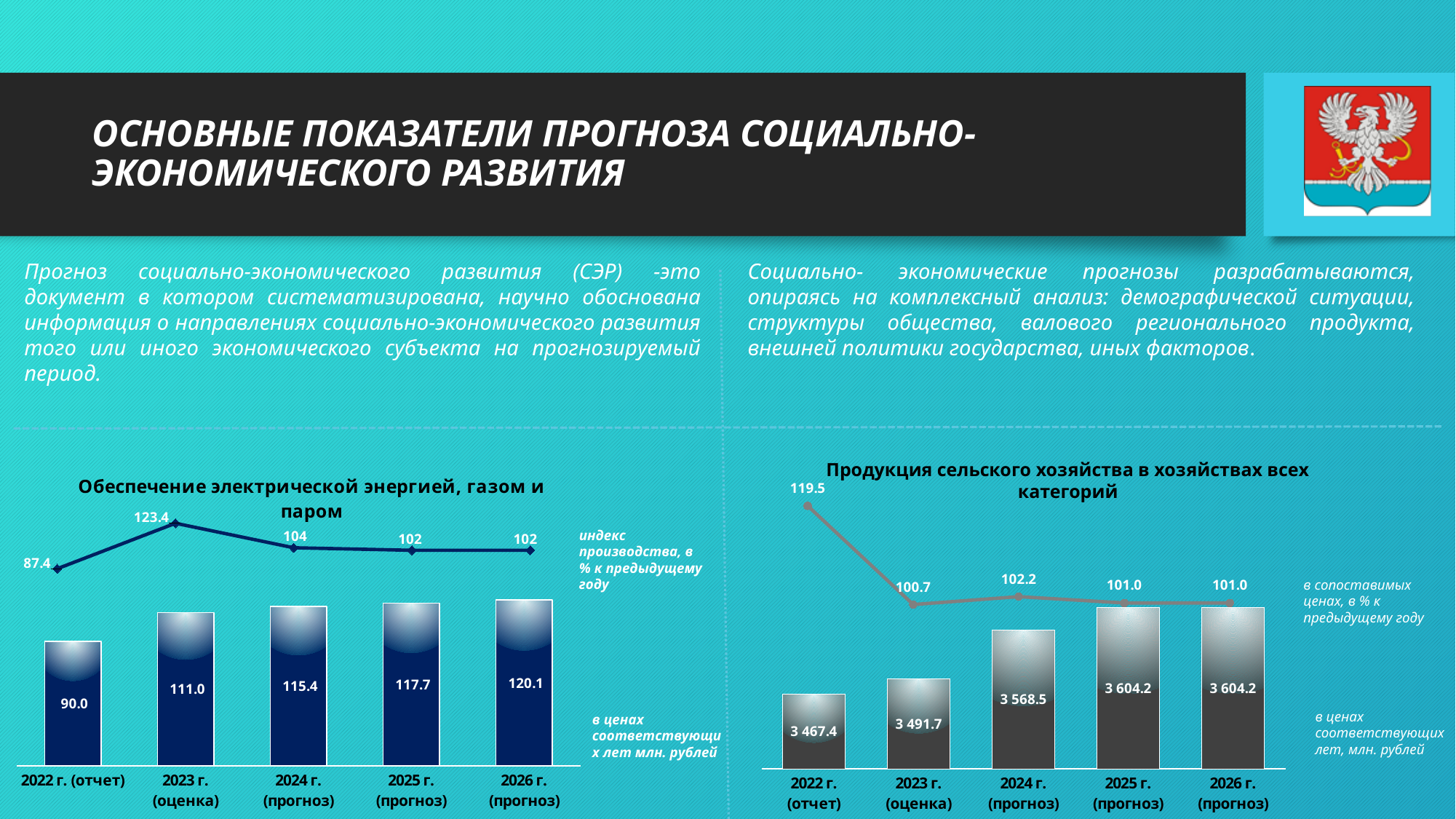
In the chart 'Продукция сельского хозяйства в хозяйствах всех категорий', which year has the lowest bar value? 2022 г. (отчет) In the chart 'Обеспечение электрической энергией, газом и паром', what is the production index (индекс производства) for 2023 г. (оценка)? 123.4 What type of chart is 'Обеспечение электрической энергией, газом и паром'? Combined bar and line chart In the chart 'Продукция сельского хозяйства в хозяйствах всех категорий', what is the line value (в сопоставимых ценах, % к предыдущему году) for 2022 г. (отчет)? 119.5 In the chart 'Продукция сельского хозяйства в хозяйствах всех категорий', what is the bar value (млн. рублей) for 2024 г. (прогноз)? 3 568.5 In the chart 'Обеспечение электрической энергией, газом и паром', how many years are shown on the x axis? 5 In the chart 'Обеспечение электрической энергией, газом и паром', which year has the highest bar value? 2026 г. (прогноз) In the chart 'Обеспечение электрической энергией, газом и паром', what is the bar value (в ценах соответствующих лет, млн. рублей) for 2022 г. (отчет)? 90.0 In the chart 'Продукция сельского хозяйства в хозяйствах всех категорий', is the bar value for 2023 г. (оценка) larger or smaller than the bar value for 2025 г. (прогноз)? smaller In the chart 'Обеспечение электрической энергией, газом и паром', do the bar values rise or fall from 2022 to 2026? rise In the chart 'Обеспечение электрической энергией, газом и паром', what is the difference between the bar values for 2026 г. (прогноз) and 2022 г. (отчет)? 30.1 In the chart 'Продукция сельского хозяйства в хозяйствах всех категорий', which year has the lowest line value? 2023 г. (оценка)